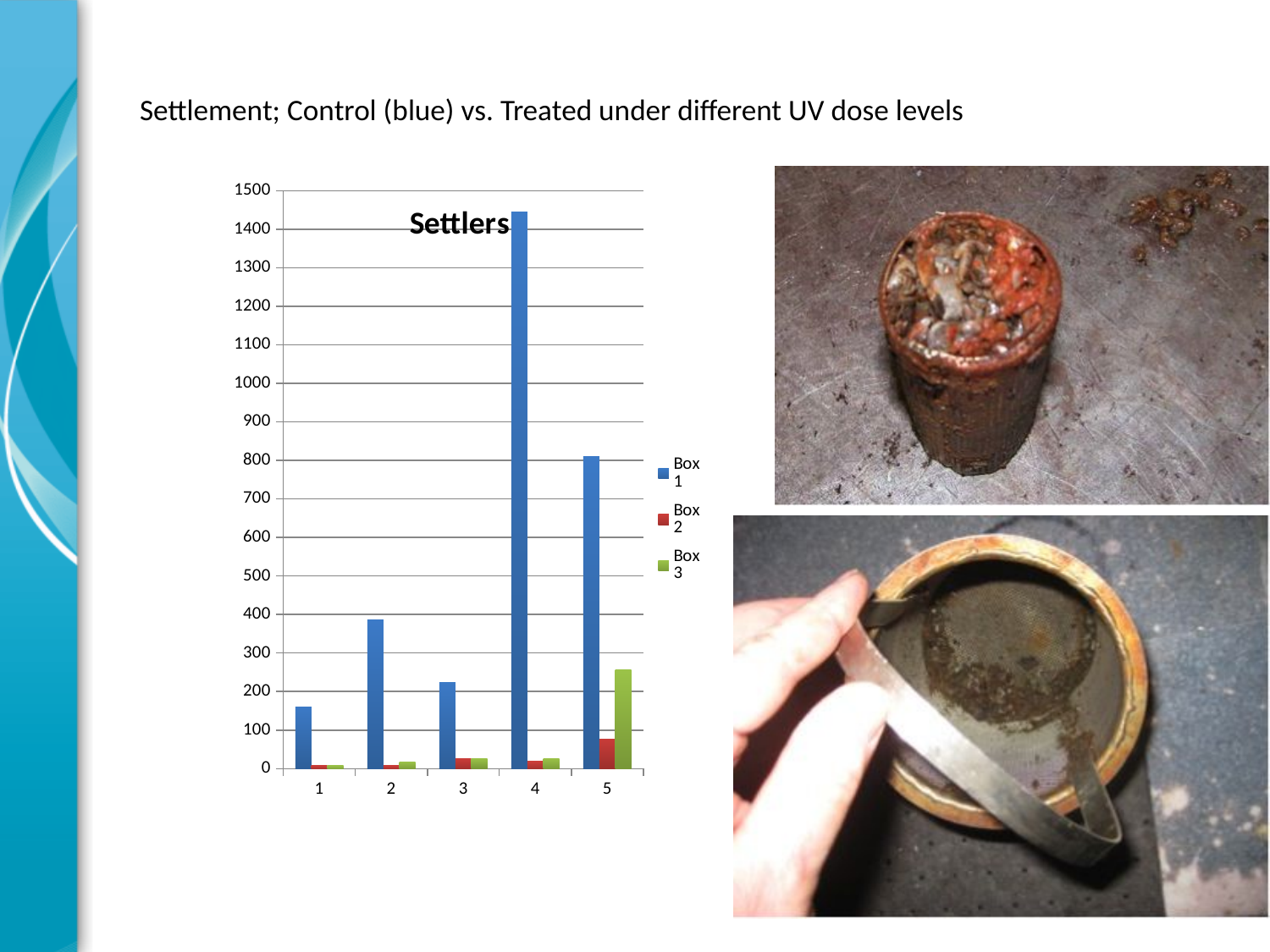
Which category has the highest value for Box 1? 4 Which is larger, the Box 1 value in category 5 or the Box 1 value in category 3? category 5 Is the value for Box 3 in category 5 greater or less than 200? greater Which colour represents Box 1 in the chart? blue Is the value for Box 1 in category 2 greater or less than 400? less How many series does the chart legend list? 3 Which category has the lowest value for Box 1? 1 What kind of chart is shown on the slide? bar chart What is the title of the chart? Settlers Which category has the highest value for Box 3? 5 How many categories are shown on the x axis of the chart? 5 Is the value for Box 1 in category 4 greater or less than 1400? greater